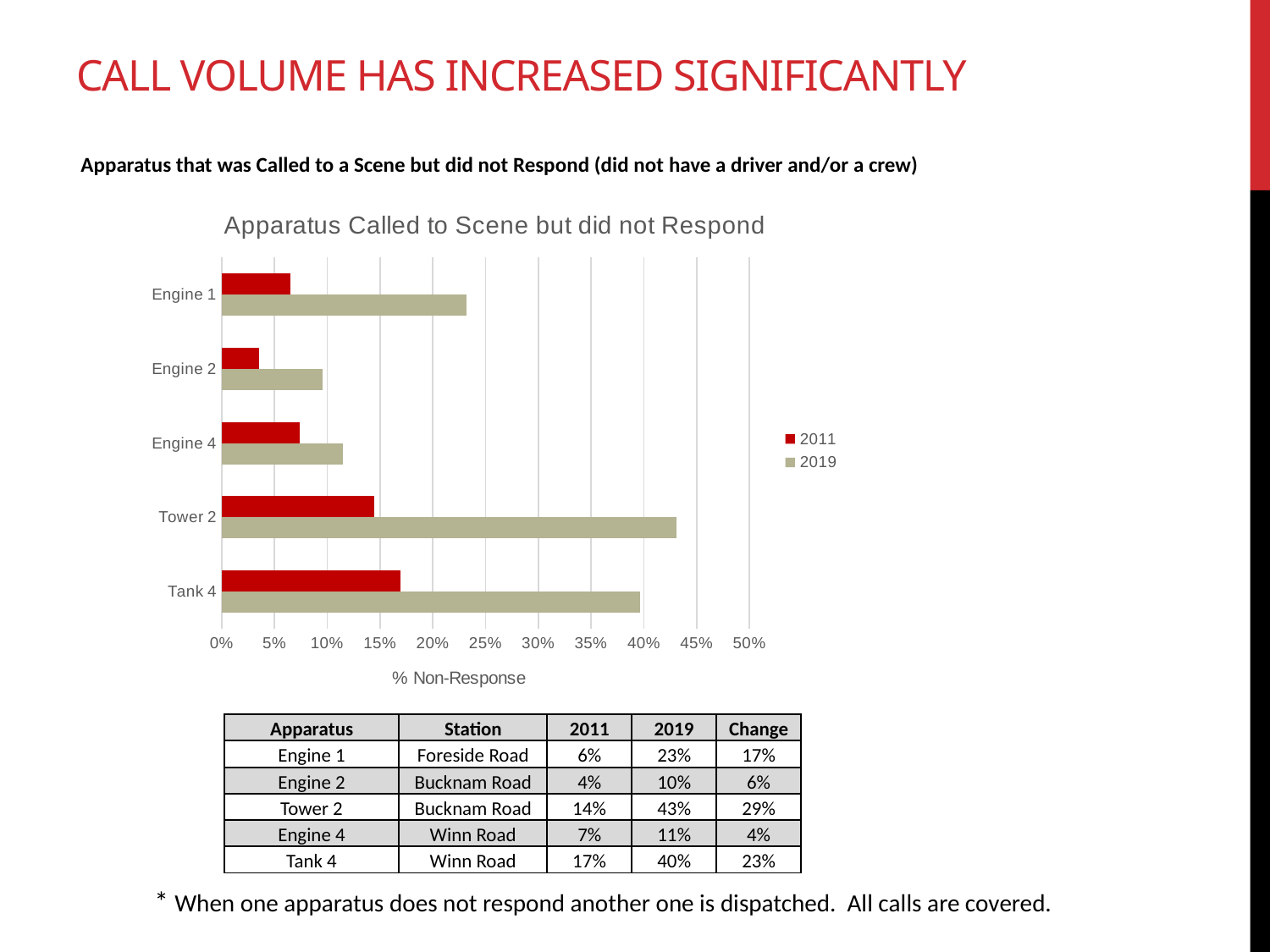
Which apparatus has the lowest 2011 non-response percentage? Engine 2 Is the 2019 value for Tank 4 greater or less than 35%? greater What is the title of the chart? Apparatus Called to Scene but did not Respond What is the 2019 non-response percentage for Tower 2? 43% How many series does the chart legend list? 2 Which apparatus has the highest 2019 non-response percentage? Tower 2 What is the 2011 non-response percentage for Tank 4? 17% What is the label on the horizontal axis of the chart? % Non-Response What is the difference between the 2019 and 2011 non-response percentages for Engine 1? 17% Which is larger, the 2019 value for Engine 2 or the 2019 value for Engine 4? Engine 4 How many apparatus categories are plotted on the chart? 5 What type of chart is shown on the slide? Bar chart